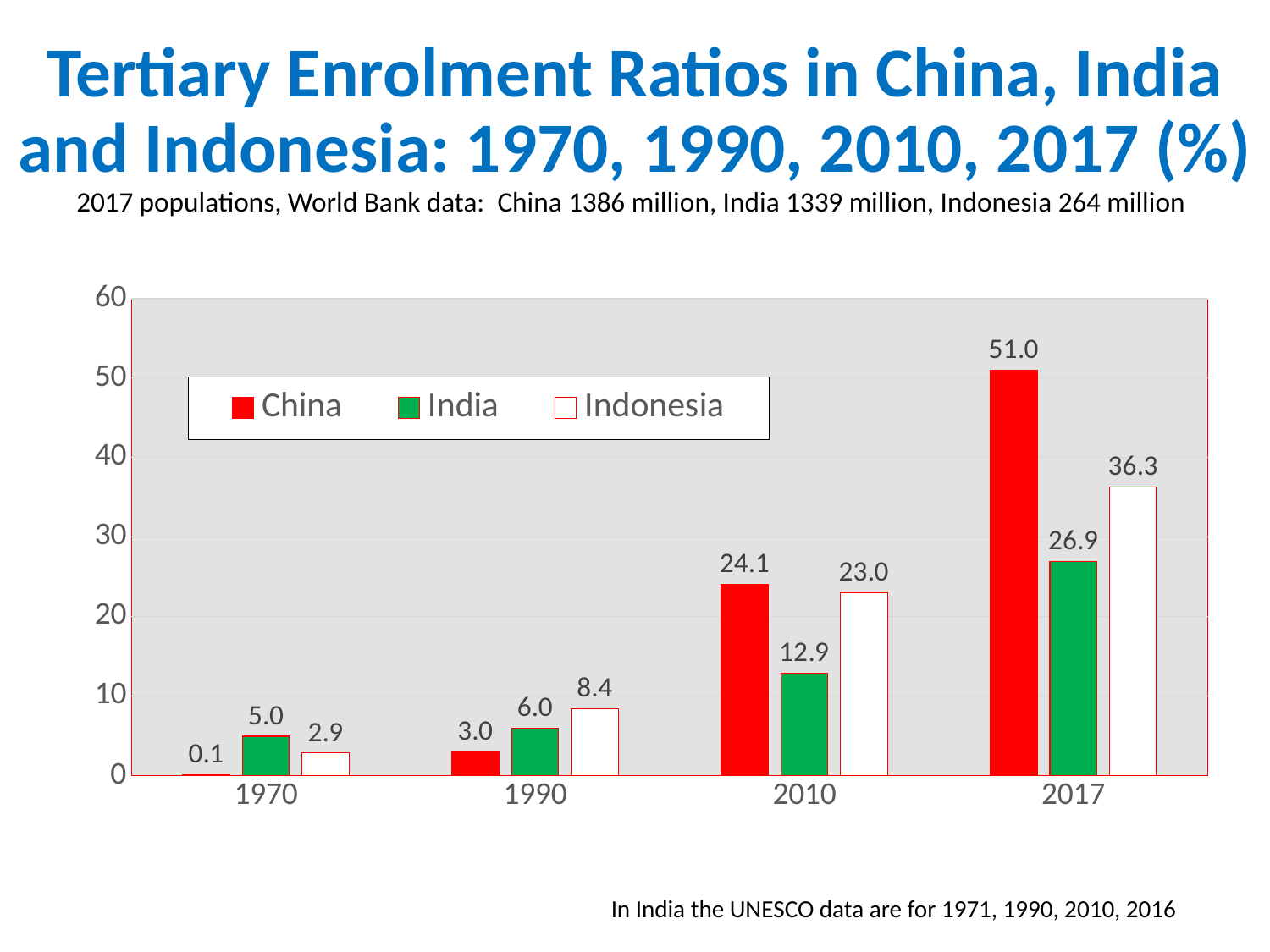
What is the tertiary enrolment ratio for China in 2017? 51.0 What is the difference between China's and India's values in 2017? 24.1 Which is larger in 2010, the value for China or the value for Indonesia? China What kind of chart is shown on the slide? bar chart Which country has the lowest value in 1970? China Which country has the highest value in 2017? China What is the value for India in 2010? 12.9 How many series does the legend list? 3 Is the value for Indonesia in 2017 greater or less than 30? greater Does the value for China rise or fall from 1990 to 2017? rise How many years are shown on the x axis? 4 What is the value for Indonesia in 1990? 8.4